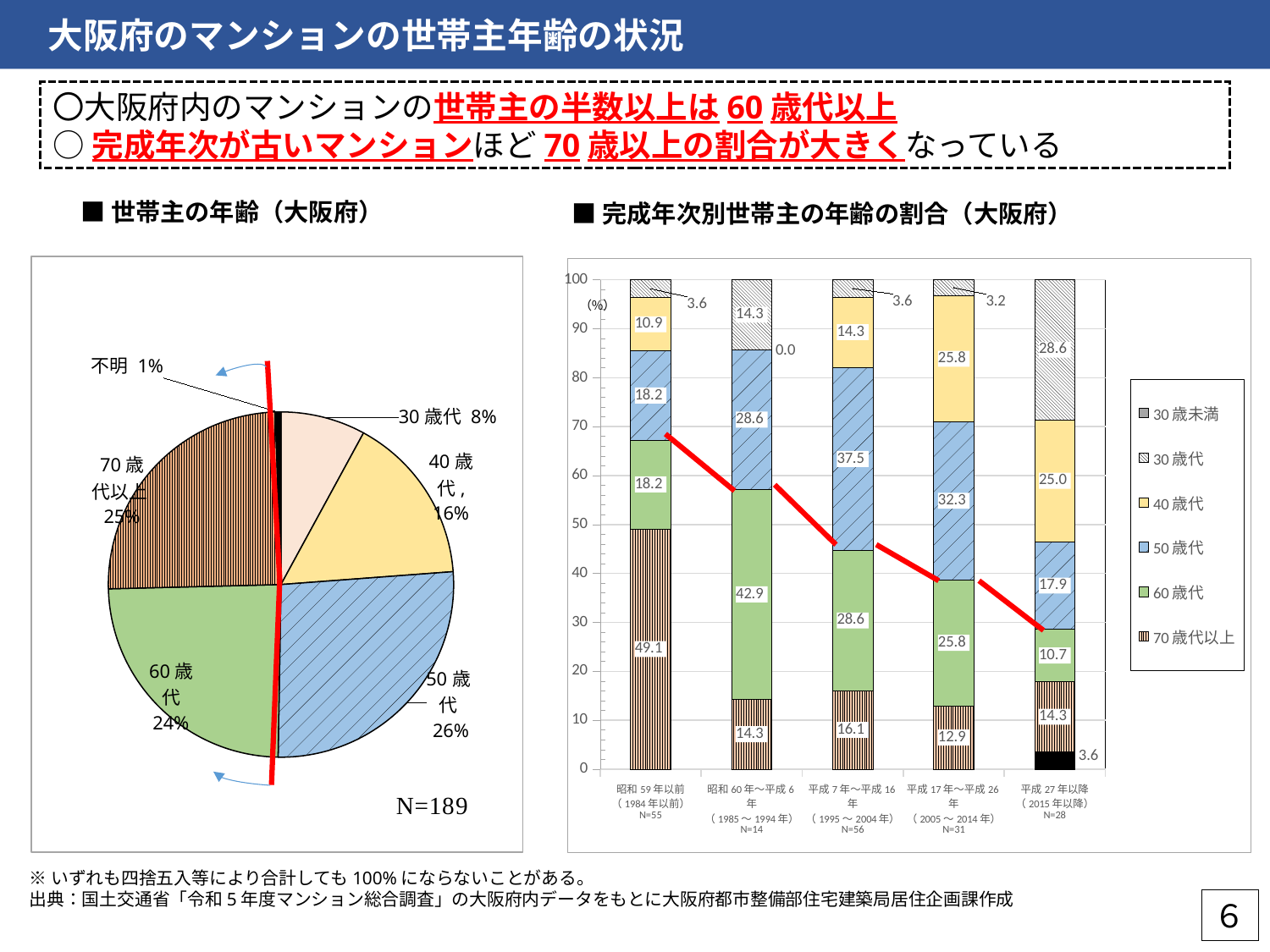
積み上げ棒グラフ「完成年次別世帯主の年齢の割合（大阪府）」で、70歳代以上の割合が最も高い完成年次区分はどれですか。 昭和59年以前 積み上げ棒グラフ「完成年次別世帯主の年齢の割合（大阪府）」で、昭和59年以前のマンションにおける70歳代以上の割合はいくらですか。 49.1 積み上げ棒グラフ「完成年次別世帯主の年齢の割合（大阪府）」で、平成27年以降のマンションにおける30歳代の割合はいくらですか。 28.6 円グラフ「世帯主の年齢（大阪府）」で、最も割合が小さい区分はどれですか。 不明 積み上げ棒グラフ「完成年次別世帯主の年齢の割合（大阪府）」で、昭和60年～平成6年の60歳代と平成7年～平成16年の60歳代では、どちらの割合が大きいですか。 昭和60年～平成6年 円グラフ「世帯主の年齢（大阪府）」で、50歳代の割合はいくらですか。 26% 円グラフ「世帯主の年齢（大阪府）」で、最も割合が大きい年齢区分はどれですか。 50歳代 円グラフ「世帯主の年齢（大阪府）」のサンプル数（N）はいくつですか。 N=189 円グラフ「世帯主の年齢（大阪府）」で、70歳代以上と40歳代の割合の差は何ポイントですか。 9ポイント 積み上げ棒グラフ「完成年次別世帯主の年齢の割合（大阪府）」には、完成年次の区分がいくつありますか。 5 積み上げ棒グラフ「完成年次別世帯主の年齢の割合（大阪府）」の凡例には、いくつの年齢区分が示されていますか。 6